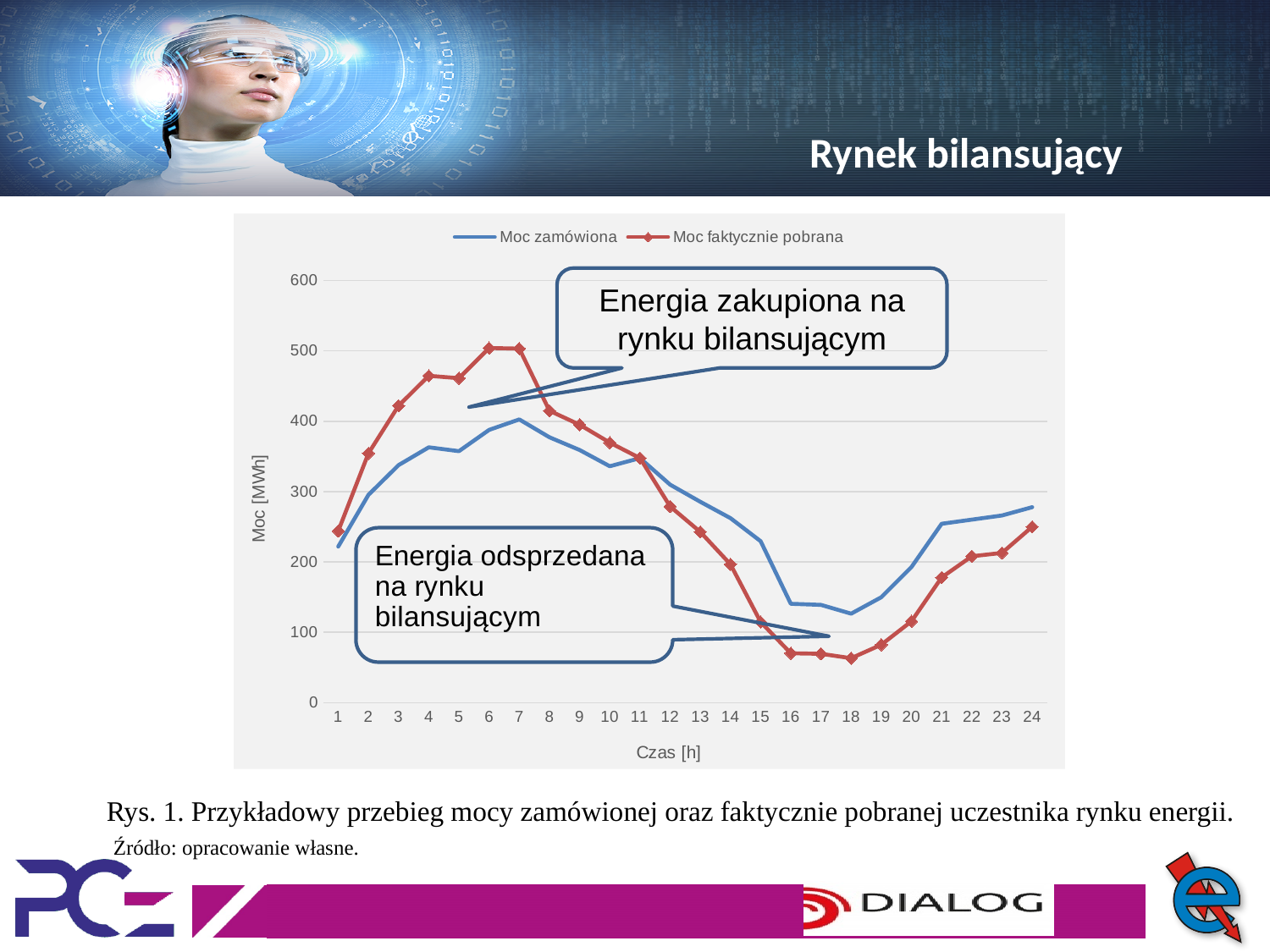
Does Moc faktycznie pobrana rise or fall between hour 7 and hour 18? Fall Is the value of Moc zamówiona at hour 18 greater or less than 200? less Is the value of Moc faktycznie pobrana at hour 4 greater or less than 400? greater Is the value of Moc faktycznie pobrana at hour 16 greater or less than 100? less How many hourly points are plotted along the x axis? 24 What is the label of the y axis? Moc [MWh] At which hour does Moc zamówiona reach its lowest value? 18 What kind of chart is shown on the slide? Line chart How many series does the chart legend list? 2 At hour 6, which series has the higher value, Moc zamówiona or Moc faktycznie pobrana? Moc faktycznie pobrana At hour 17, which series has the higher value, Moc zamówiona or Moc faktycznie pobrana? Moc zamówiona